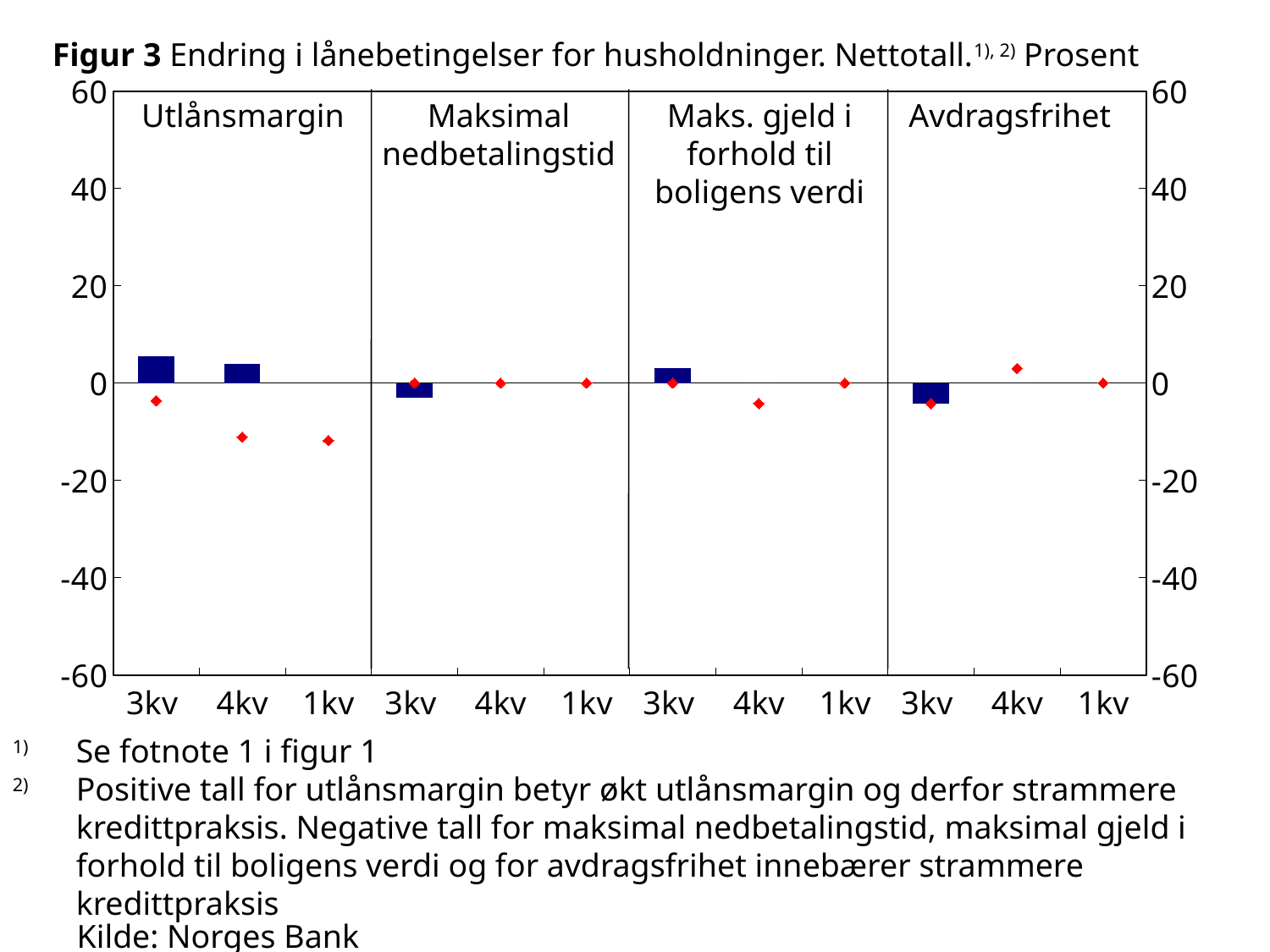
What is the highest value shown on the y axis? 60 How many quarters are shown on the x axis within each panel? 3 What kind of chart is shown in Figur 3? combination bar and line chart (bars with red diamond markers) Which is larger, the 3kv bar in the Utlånsmargin panel or the 3kv bar in the Maks. gjeld i forhold til boligens verdi panel? Utlånsmargin 3kv What is the title of the chart? Figur 3 Endring i lånebetingelser for husholdninger. Nettotall. Prosent Do the red diamonds in the Utlånsmargin panel rise or fall from 3kv to 1kv? fall Is the bar for 3kv in the Avdragsfrihet panel greater or less than 0? less Is the red diamond for 4kv in the Utlånsmargin panel greater or less than 0? less Is the bar for 3kv in the Utlånsmargin panel greater or less than 20? less How many panels (lending condition categories) does the chart have? 4 Which panel contains the tallest positive bar? Utlånsmargin